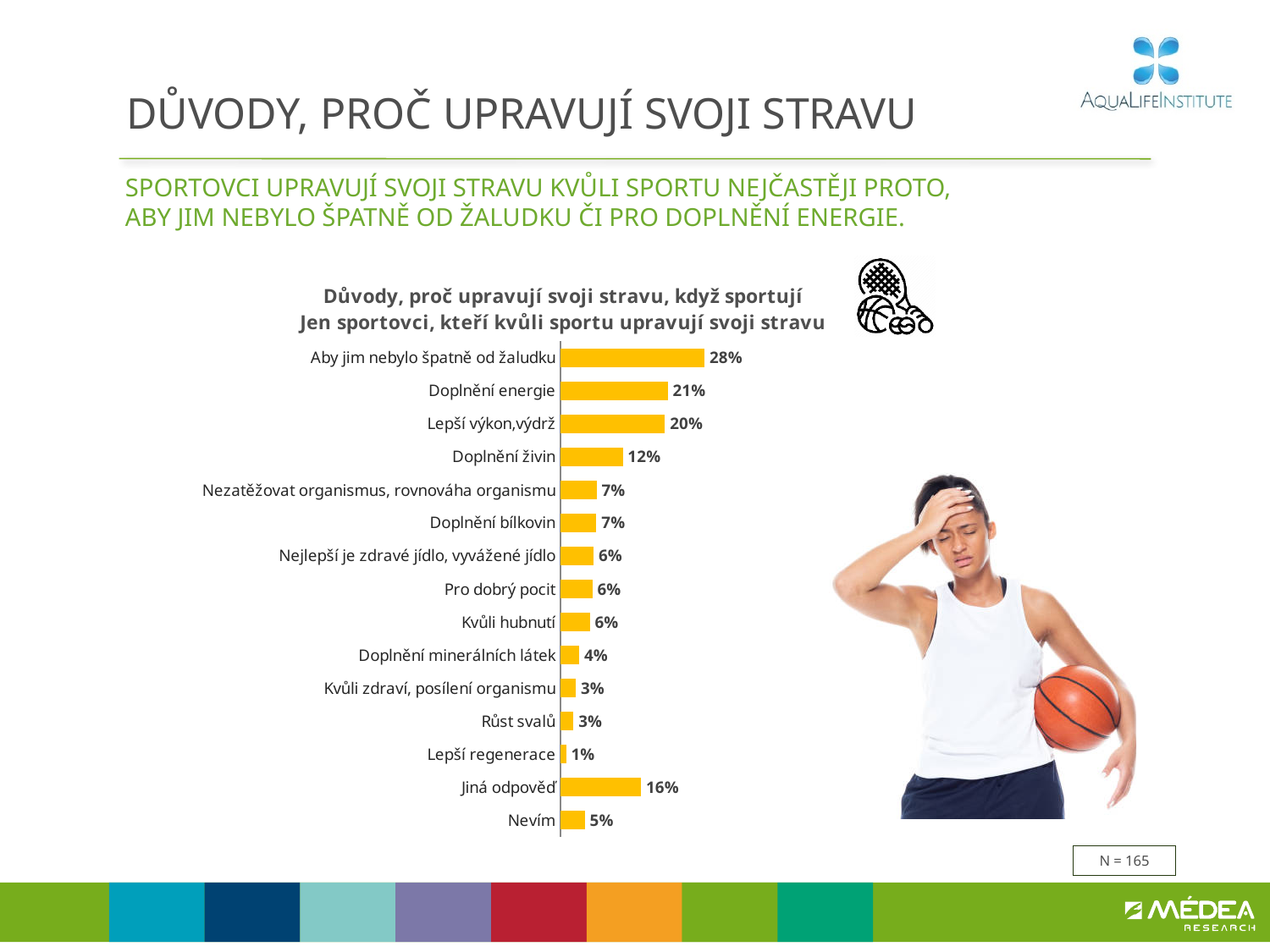
What colour are the bars in the chart? Yellow What is the value for "Lepší regenerace"? 1% Which category has the highest value? Aby jim nebylo špatně od žaludku What is the difference between the values for "Lepší výkon,výdrž" and "Doplnění živin"? 8% Which category has the lowest value? Lepší regenerace What kind of chart is shown on the slide? Bar chart What is the value for "Doplnění energie"? 21% What is the value for "Aby jim nebylo špatně od žaludku"? 28% What is the difference between the values for "Aby jim nebylo špatně od žaludku" and "Doplnění energie"? 7% How many categories are shown in the chart? 15 Which is larger, the value for "Doplnění živin" or the value for "Jiná odpověď"? Jiná odpověď What is the value for "Jiná odpověď"? 16%